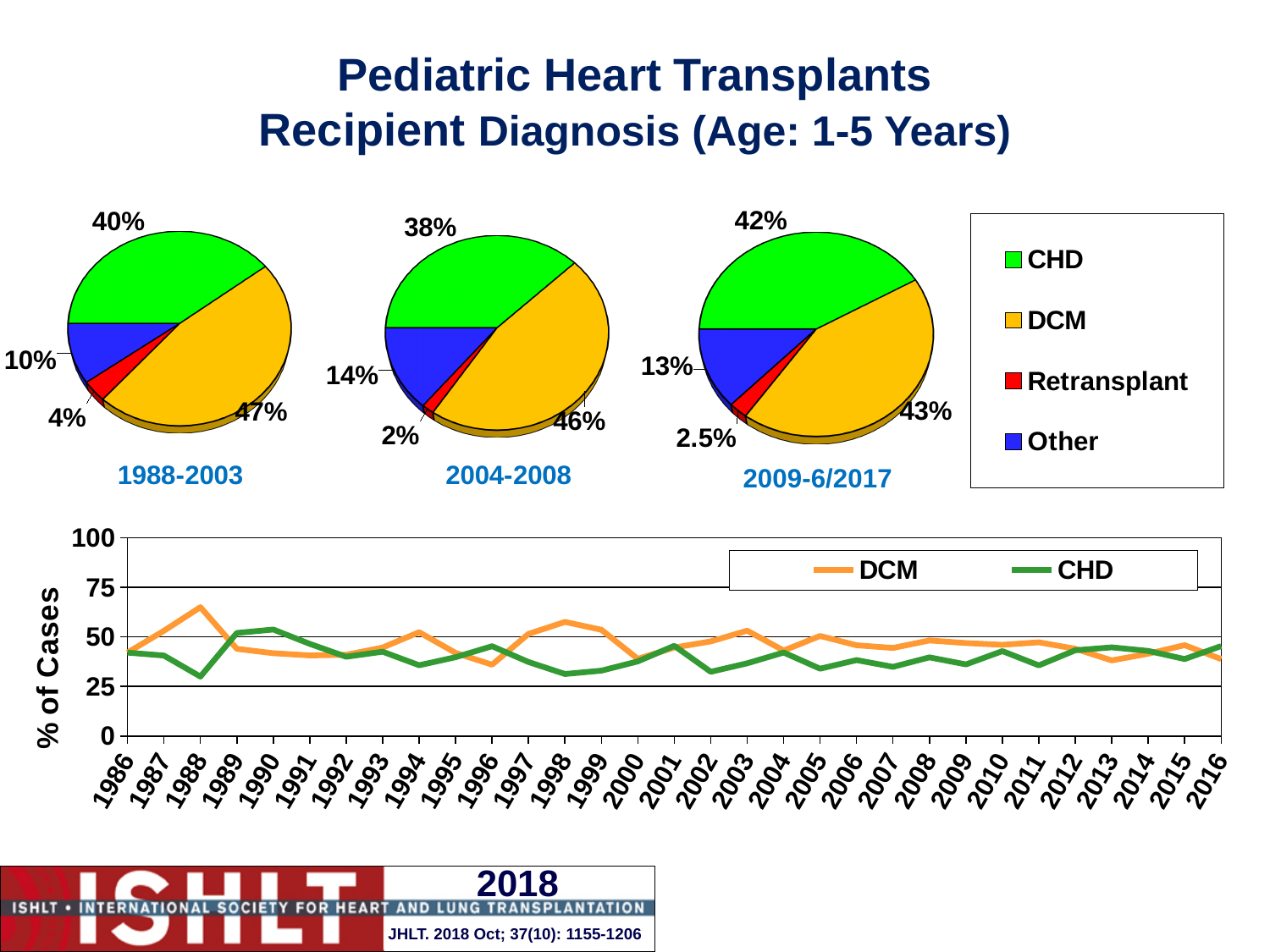
In the bottom line chart, is the DCM value for 1988 greater or less than 50? greater How many slices does the 1988-2003 pie chart have? 4 In the 2009-6/2017 pie chart, what share of cases is Retransplant? 2.5% How many series does the legend of the bottom line chart list? 2 In the 2004-2008 pie chart, which diagnosis has the smallest share? Retransplant In the bottom line chart, is the CHD value for 1988 greater or less than 50? less In the 1988-2003 pie chart, what is the difference between the DCM share and the CHD share? 7% In the 2004-2008 pie chart, what share of cases is Other? 14% In the 2004-2008 pie chart, which is larger, the Other share or the Retransplant share? Other What kind of chart is the bottom chart showing % of Cases by year? Line chart In the 2009-6/2017 pie chart, which diagnosis has the largest share? DCM In the 1988-2003 pie chart, what share of cases is CHD? 40%